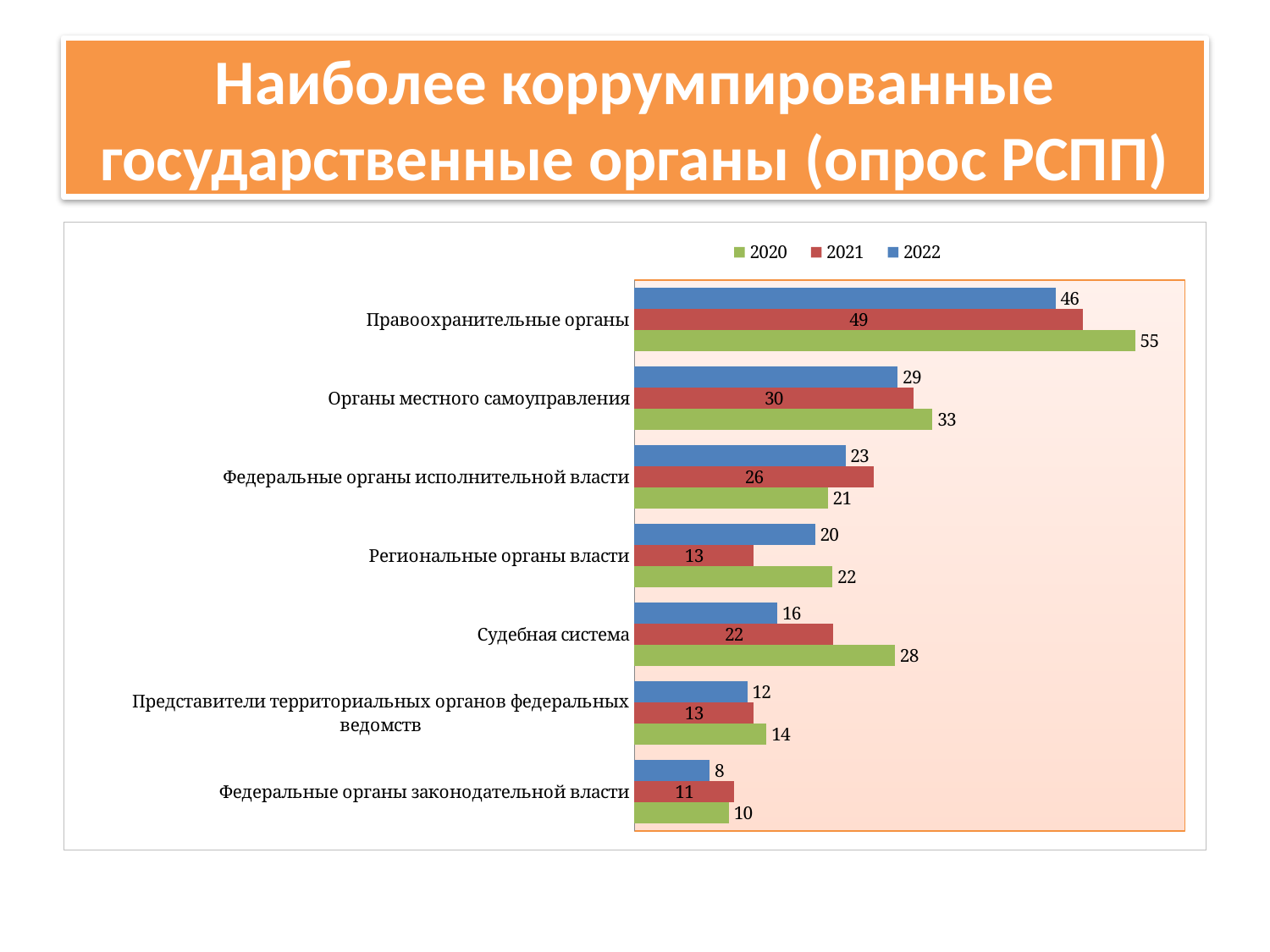
Which is larger for Федеральные органы исполнительной власти: the 2021 value or the 2020 value? 2021 How many categories are shown in the chart? 7 Which category has the lowest 2022 value? Федеральные органы законодательной власти What is the 2021 value for Региональные органы власти? 13 How many series does the legend list? 3 Which series is shown in green in the legend? 2020 What is the difference between the 2021 and 2022 values for Судебная система? 6 What is the 2022 value for Правоохранительные органы? 46 What is the 2020 value for Судебная система? 28 What is the difference between the 2020 and 2022 values for Правоохранительные органы? 9 Which category has the highest 2020 value? Правоохранительные органы What kind of chart is shown on the slide? Bar chart